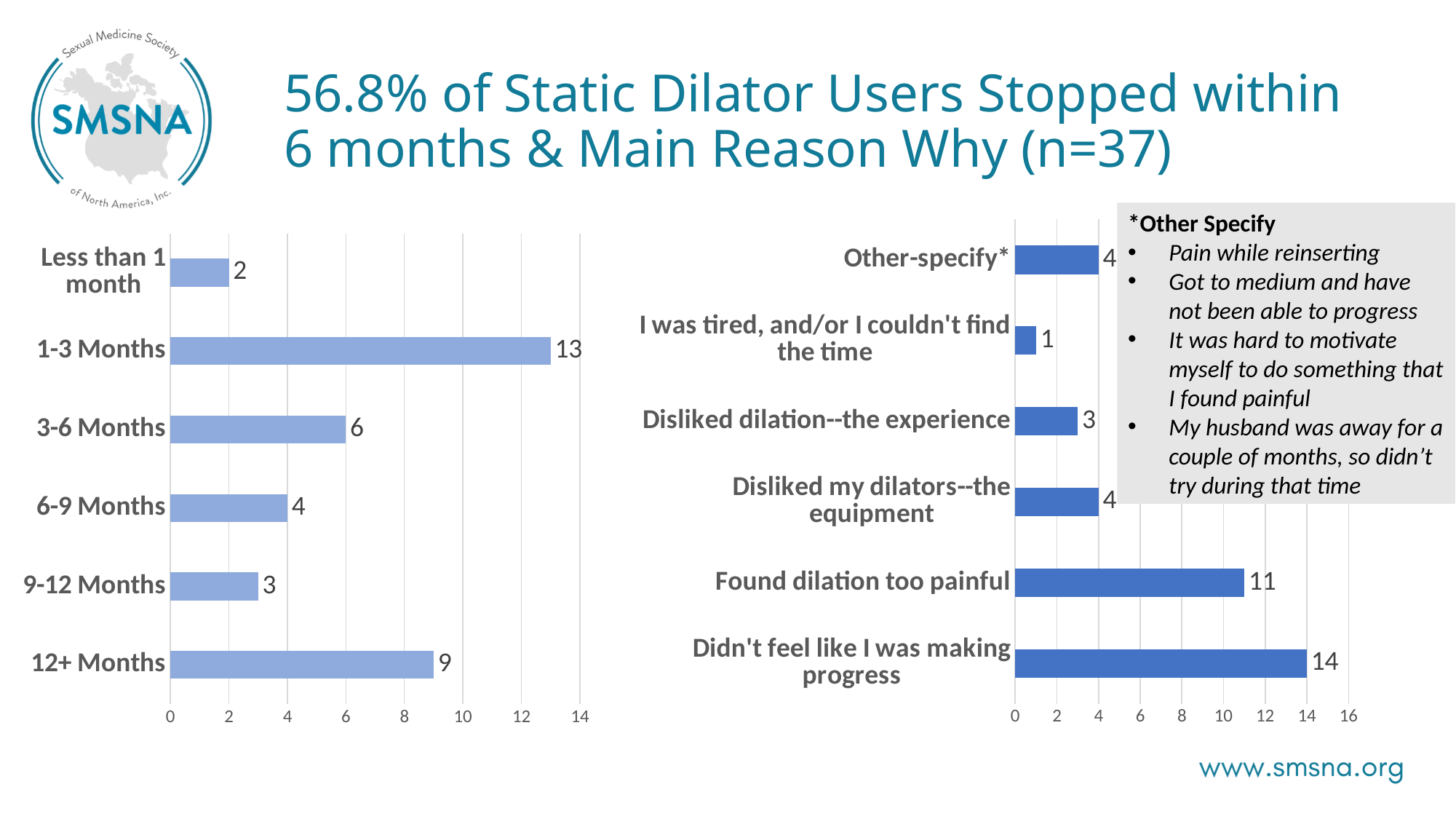
In the left chart, what is the value for 12+ Months? 9 In the left chart, which category has the highest value? 1-3 Months What type of chart is the right chart? Bar chart In the left chart, which category has the lowest value? Less than 1 month In the left chart, what is the value for 1-3 Months? 13 In the right chart, which is larger: the value for Disliked dilation--the experience or the value for Disliked my dilators--the equipment? Disliked my dilators--the equipment In the right chart, what is the value for Found dilation too painful? 11 In the left chart, what is the difference between the values for 1-3 Months and 3-6 Months? 7 In the right chart, which category has the lowest value? I was tired, and/or I couldn't find the time In the left chart, how many categories are shown? 6 In the right chart, which category has the highest value? Didn't feel like I was making progress In the right chart, what is the difference between the values for Didn't feel like I was making progress and Found dilation too painful? 3